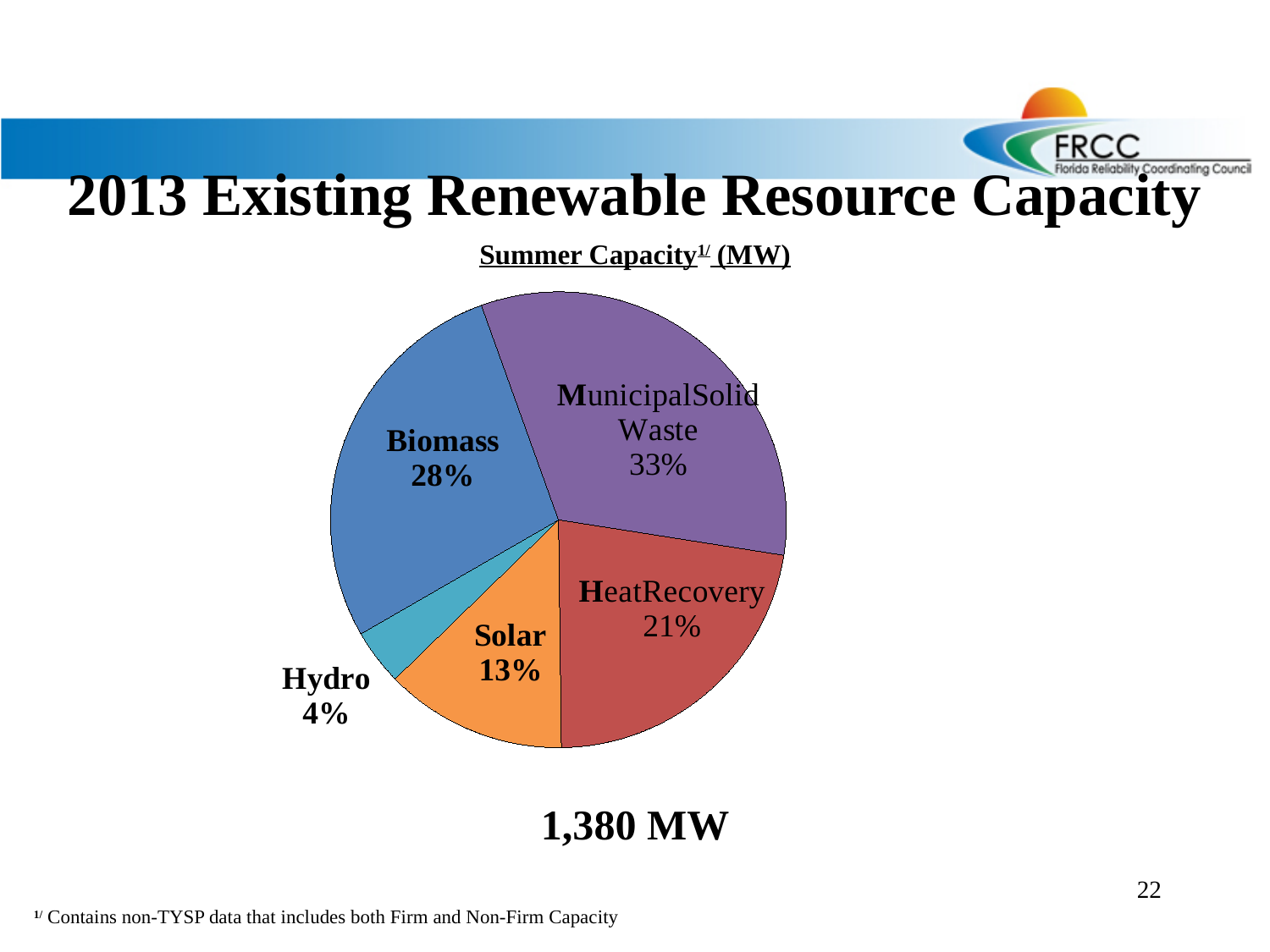
What total capacity is printed below the pie chart? 1,380 MW What share of the pie does Hydro represent? 4% Which is larger, the share for Biomass or the share for Heat Recovery? Biomass What share of the pie does Heat Recovery represent? 21% What share of the pie does Solar represent? 13% Which category has the smallest slice of the pie? Hydro How many slices does the pie chart have? 5 What kind of chart is shown on the slide? pie chart What is the difference in percentage points between the Municipal Solid Waste share and the Solar share? 20 percentage points Which category has the largest slice of the pie? Municipal Solid Waste